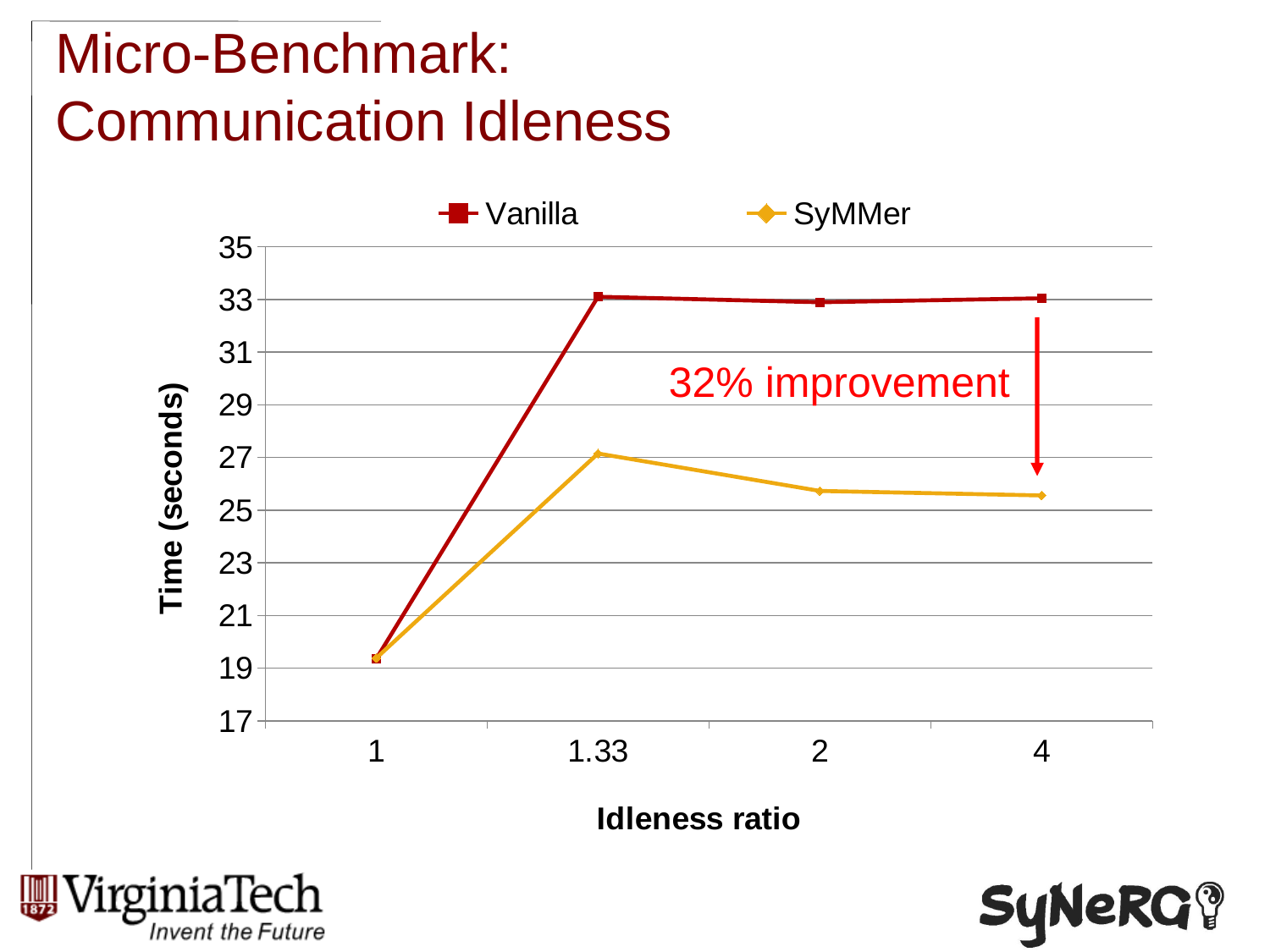
What kind of chart is shown on the slide? line chart How many series does the legend list? 2 How many idleness ratio values are plotted along the x axis? 4 At an idleness ratio of 2, which series has the lower time, Vanilla or SyMMer? SyMMer Does the SyMMer series rise or fall from an idleness ratio of 1.33 to 4? fall What improvement percentage is annotated on the chart? 32% improvement At an idleness ratio of 4, which series has the higher time, Vanilla or SyMMer? Vanilla Is the Vanilla value at an idleness ratio of 1 greater or less than 21? less At which idleness ratio does the SyMMer series reach its highest time? 1.33 At which idleness ratio does the Vanilla series have its lowest time? 1 Is the SyMMer value at an idleness ratio of 4 greater or less than 27? less Is the Vanilla value at an idleness ratio of 1.33 greater or less than 31? greater